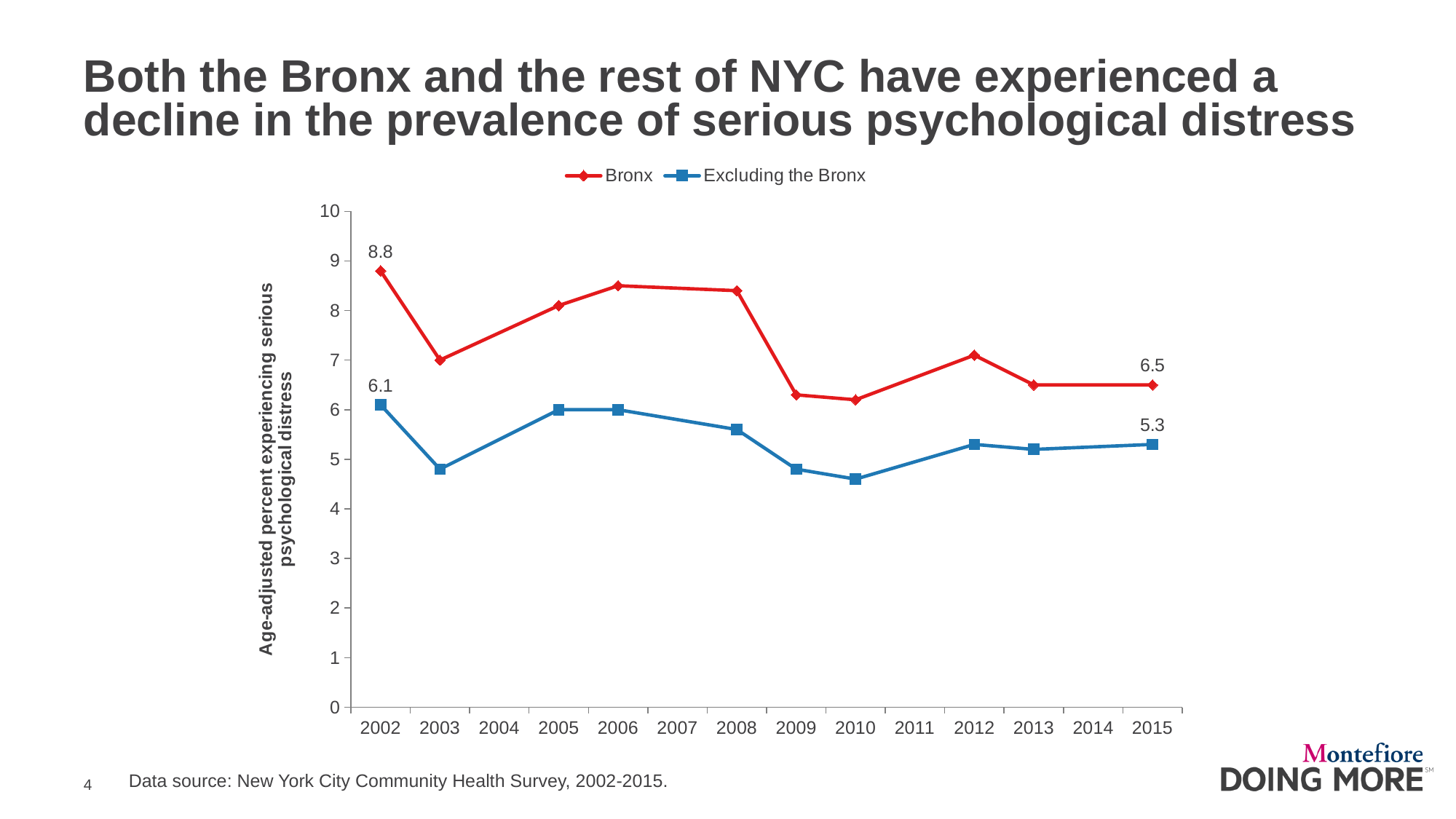
By how much did the Bronx value fall from 2002 to 2015? 2.3 What is the value for the Bronx in 2002? 8.8 Is the value for Excluding the Bronx in 2010 greater or less than 5? less How many series does the legend list? 2 What is the value for Excluding the Bronx in 2015? 5.3 In which year is the Bronx series at its highest? 2002 Which series has the larger value in 2002, Bronx or Excluding the Bronx? Bronx Do the values for the Bronx generally rise or fall from 2002 to 2015? Fall What is the difference between the Bronx and Excluding the Bronx values in 2015? 1.2 What type of chart is shown on the slide? Line chart What is the value for the Bronx in 2015? 6.5 What is the value for Excluding the Bronx in 2002? 6.1